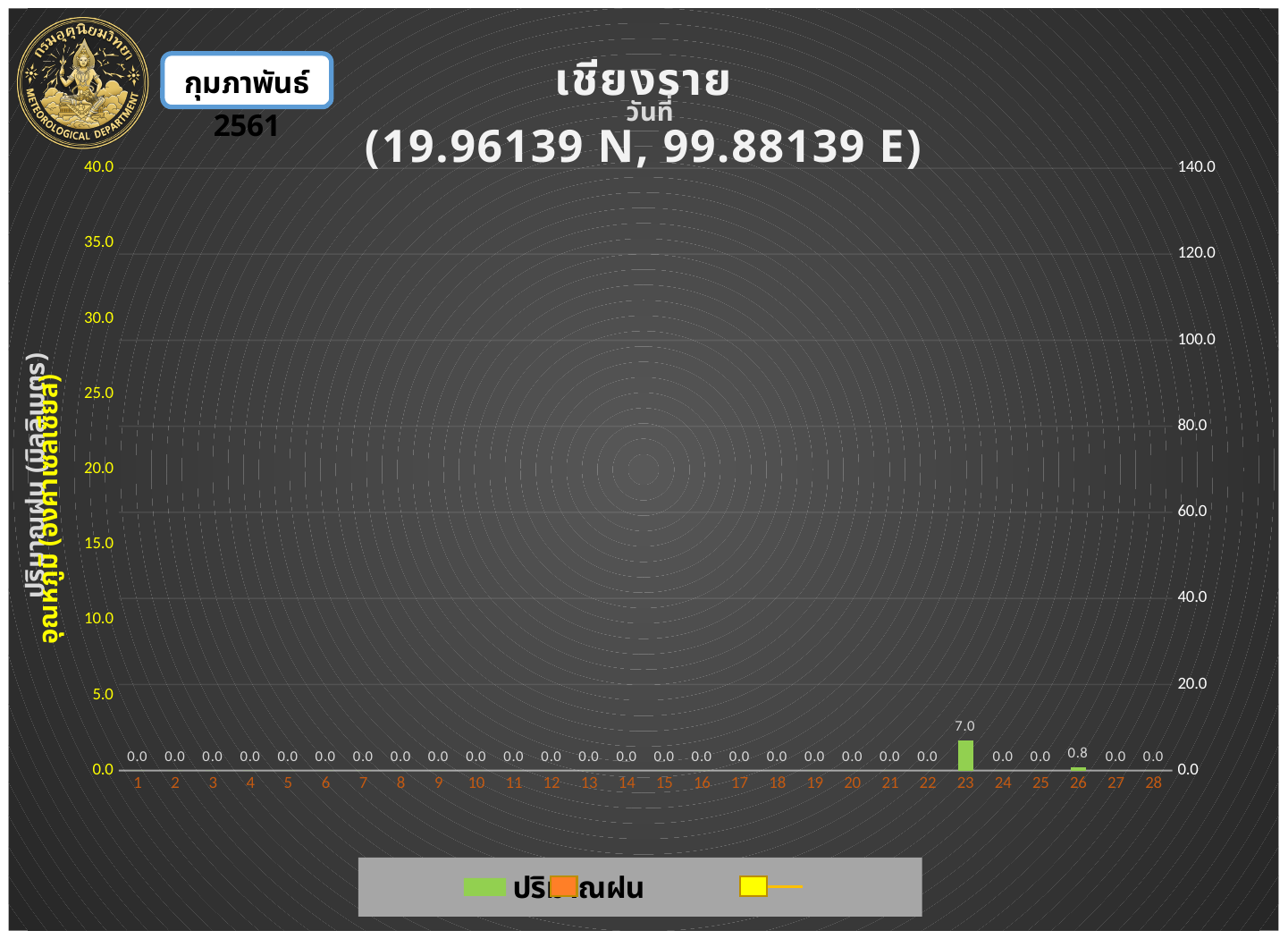
Which has the larger rainfall value, day 23 or day 26? Day 23 How many days are shown on the x axis? 28 What is the rainfall value shown for day 26? 0.8 What coordinates are shown in the chart title? (19.96139 N, 99.88139 E) What is the rainfall value shown for day 23? 7.0 Is the rainfall value for day 23 greater or less than 10.0? less What is the rainfall value shown for day 10? 0.0 What is the name of the station shown in the chart title? เชียงราย How many days have a rainfall value greater than 0.0? 2 Which day has the highest rainfall value? 23 What kind of chart is shown on the slide? Bar chart What is the difference between the rainfall values for day 23 and day 26? 6.2